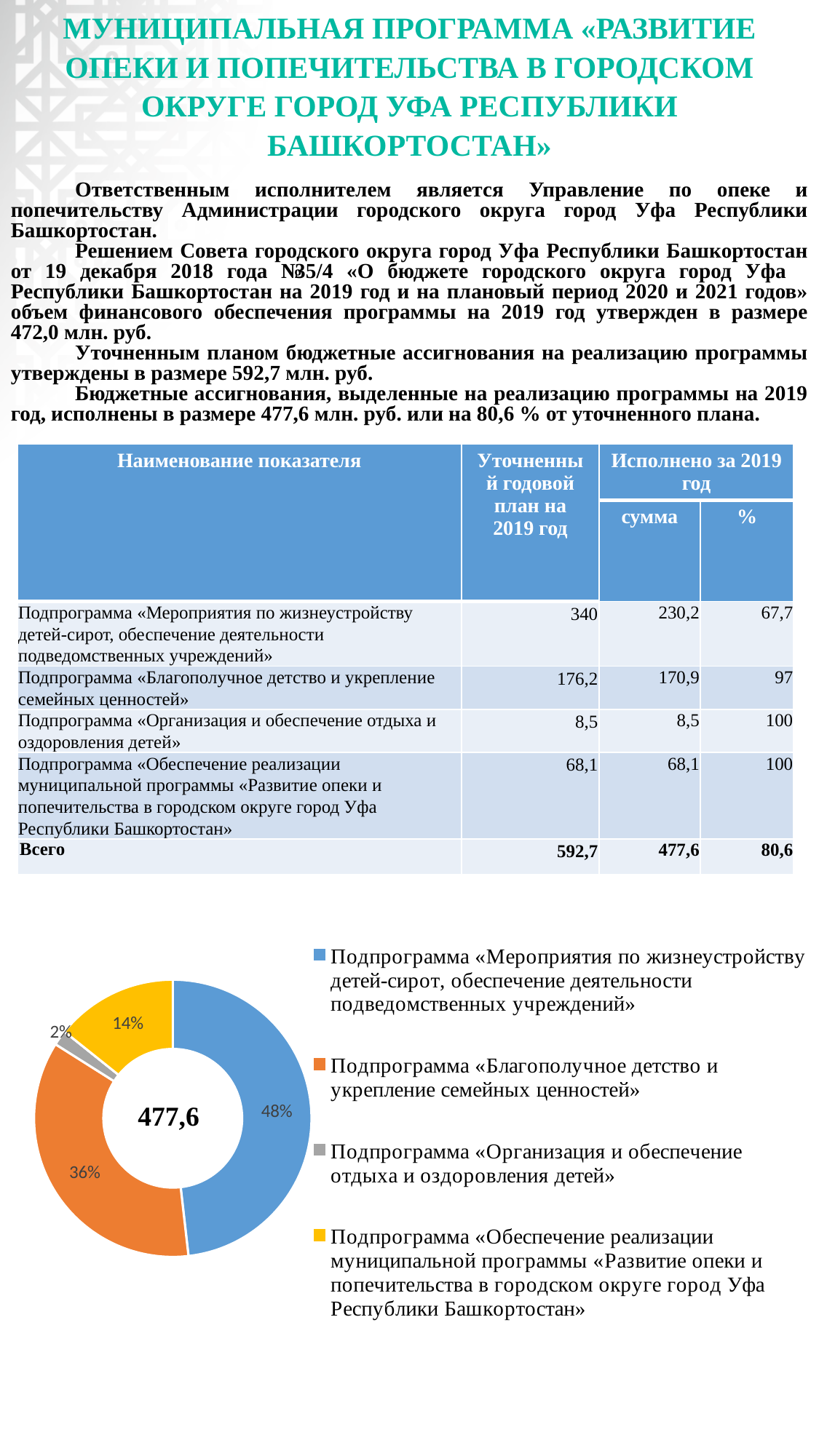
What share of the doughnut chart does the subprogramme «Организация и обеспечение отдыха и оздоровления детей» take? 2% What share of the doughnut chart does the subprogramme «Обеспечение реализации муниципальной программы «Развитие опеки и попечительства в городском округе город Уфа Республики Башкортостан»» take? 14% What colour is the slice for «Организация и обеспечение отдыха и оздоровления детей» in the doughnut chart? Grey Which slice is larger in the doughnut chart: «Благополучное детство и укрепление семейных ценностей» or «Обеспечение реализации муниципальной программы...»? Подпрограмма «Благополучное детство и укрепление семейных ценностей» Which subprogramme has the largest slice in the doughnut chart? Подпрограмма «Мероприятия по жизнеустройству детей-сирот, обеспечение деятельности подведомственных учреждений» Which subprogramme has the smallest slice in the doughnut chart? Подпрограмма «Организация и обеспечение отдыха и оздоровления детей» By how many percentage points does the 48% slice exceed the 36% slice in the doughnut chart? 12 percentage points How many slices does the doughnut chart have? 4 What share of the doughnut chart does the subprogramme «Благополучное детство и укрепление семейных ценностей» take? 36% What kind of chart is shown at the bottom of the slide? Doughnut (pie) chart What value is printed in the centre of the doughnut chart? 477,6